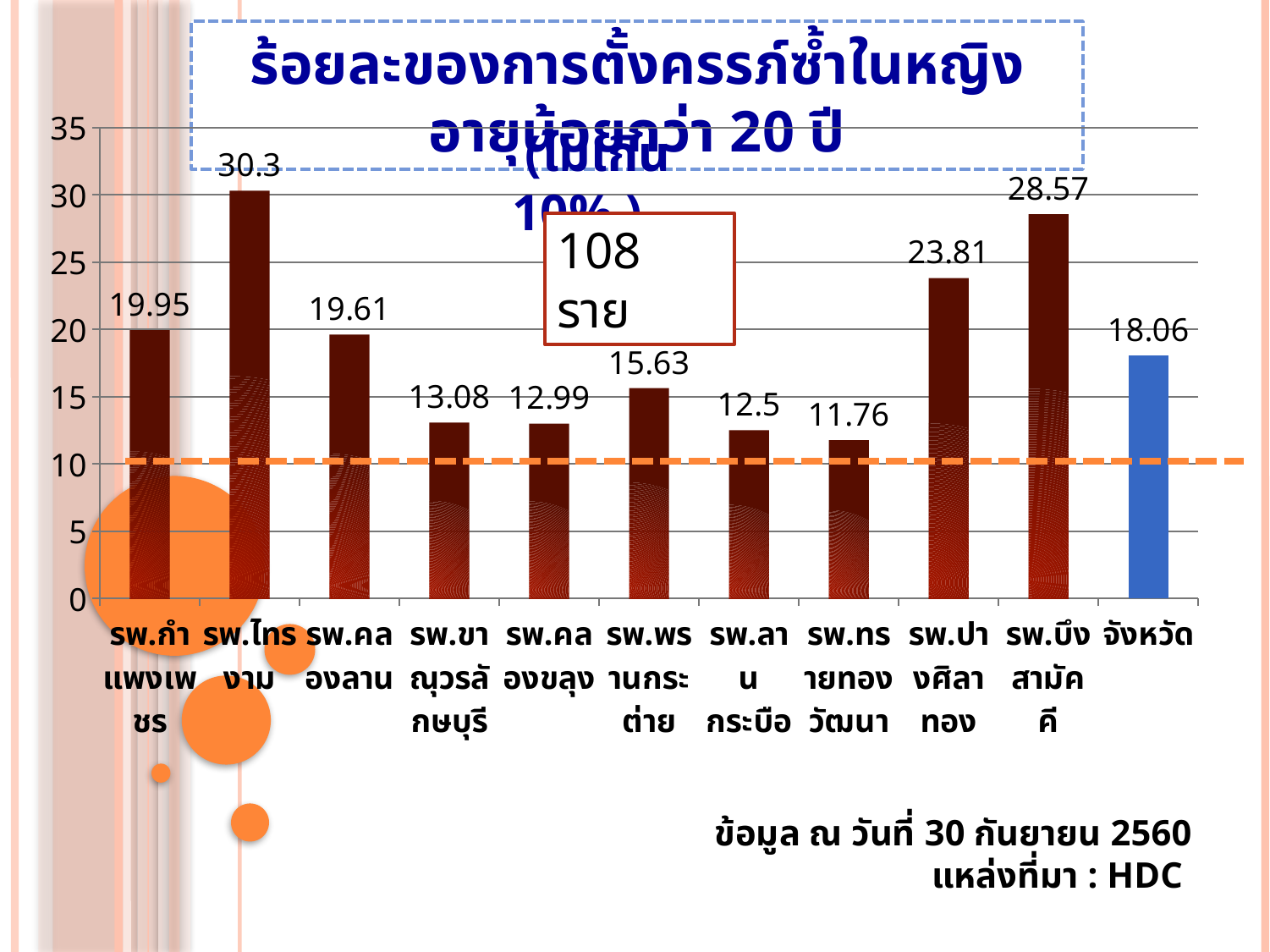
What kind of chart is shown on the slide? bar chart Which is larger, the value for รพ.ปางศิลาทอง or the value for รพ.กำแพงเพชร? รพ.ปางศิลาทอง Which category has the highest value? รพ.ไทรงาม At what value on the y axis is the horizontal dashed line drawn? 10 Is the value for รพ.ลานกระบือ greater or less than 15? less What is the value for รพ.บึงสามัคคี? 28.57 Which category has the lowest value? รพ.ทรายทองวัฒนา What is the value for รพ.ไทรงาม? 30.3 What is the value for จังหวัด? 18.06 What is the difference between the values for รพ.ไทรงาม and รพ.บึงสามัคคี? 1.73 What is the value for รพ.ทรายทองวัฒนา? 11.76 How many categories are shown on the x axis? 11